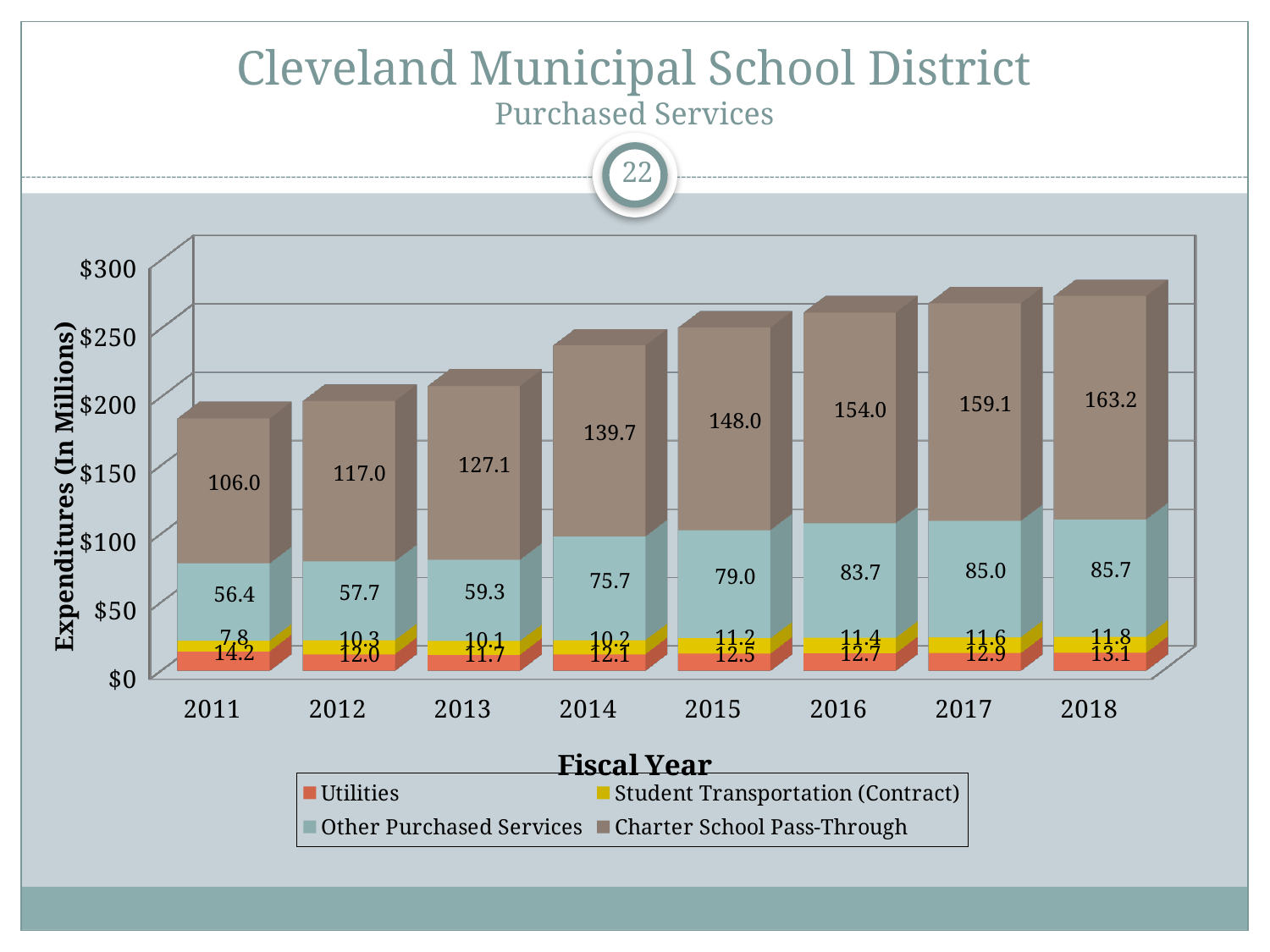
What is the Other Purchased Services value for 2017? 85.0 Do the Charter School Pass-Through values rise or fall from 2011 to 2018? Rise What is the Charter School Pass-Through value for 2014? 139.7 What type of chart is shown on the slide? Stacked bar chart What is the Utilities value for 2011? 14.2 How many fiscal years are shown on the x axis? 8 How many series does the legend list? 4 Which fiscal year has the highest Charter School Pass-Through value? 2018 Which is larger, the Other Purchased Services value for 2013 or for 2014? 2014 What is the difference between the Charter School Pass-Through values for 2018 and 2011? 57.2 What is the total of the stacked bar for 2015? 250.7 Which fiscal year has the lowest Other Purchased Services value? 2011